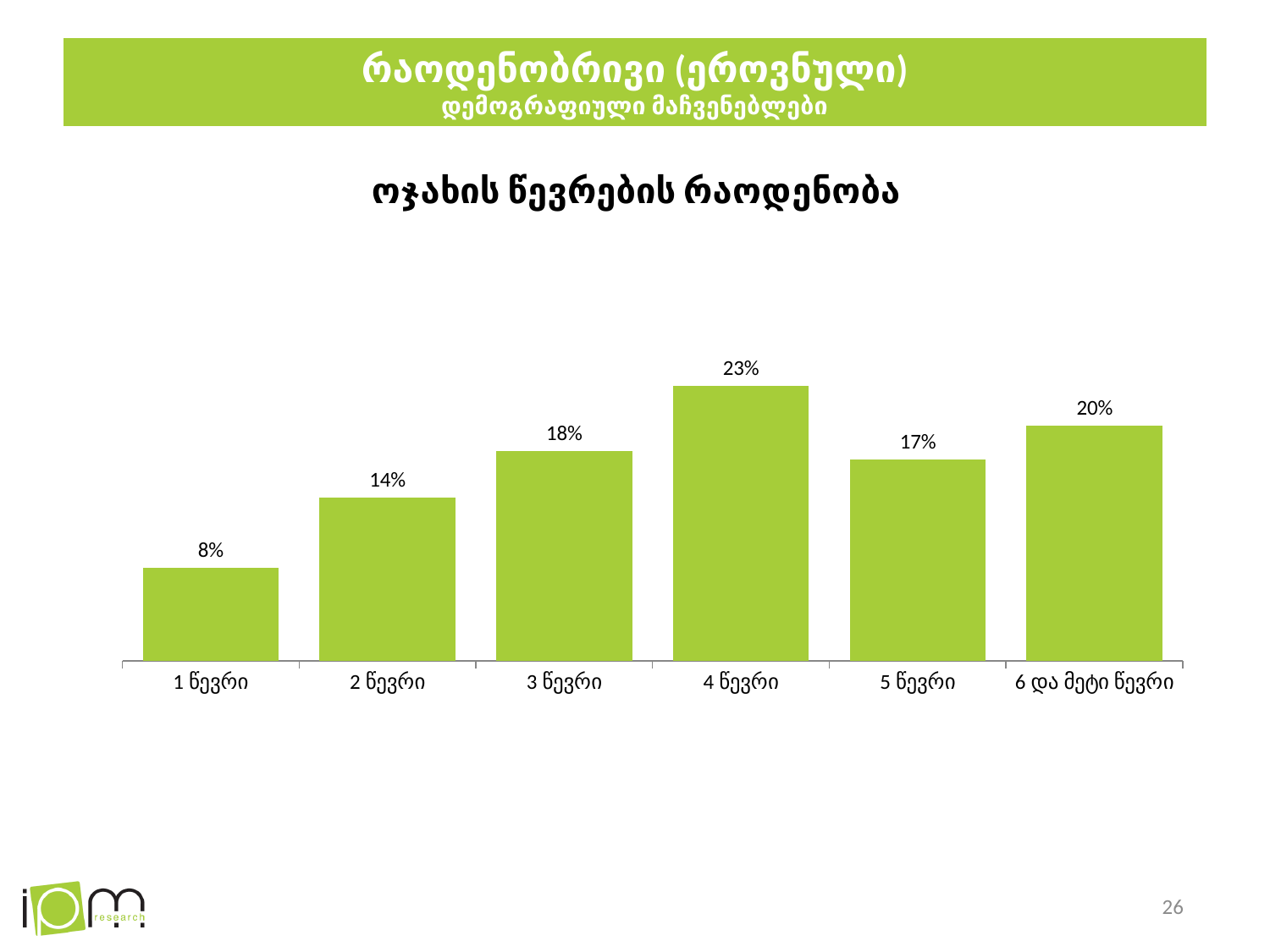
What is the value for "5 წევრი"? 17% Which category has the lowest value? 1 წევრი What is the difference between the values for "3 წევრი" and "2 წევრი"? 4% What kind of chart is shown on the slide? Bar chart What is the value for "1 წევრი"? 8% How many categories are shown on the chart? 6 Which is larger, the value for "6 და მეტი წევრი" or the value for "5 წევრი"? 6 და მეტი წევრი What is the title of the chart? ოჯახის წევრების რაოდენობა What is the value for "4 წევრი"? 23% What is the value for "6 და მეტი წევრი"? 20% Which category has the highest value? 4 წევრი What is the difference between the values for "4 წევრი" and "1 წევრი"? 15%